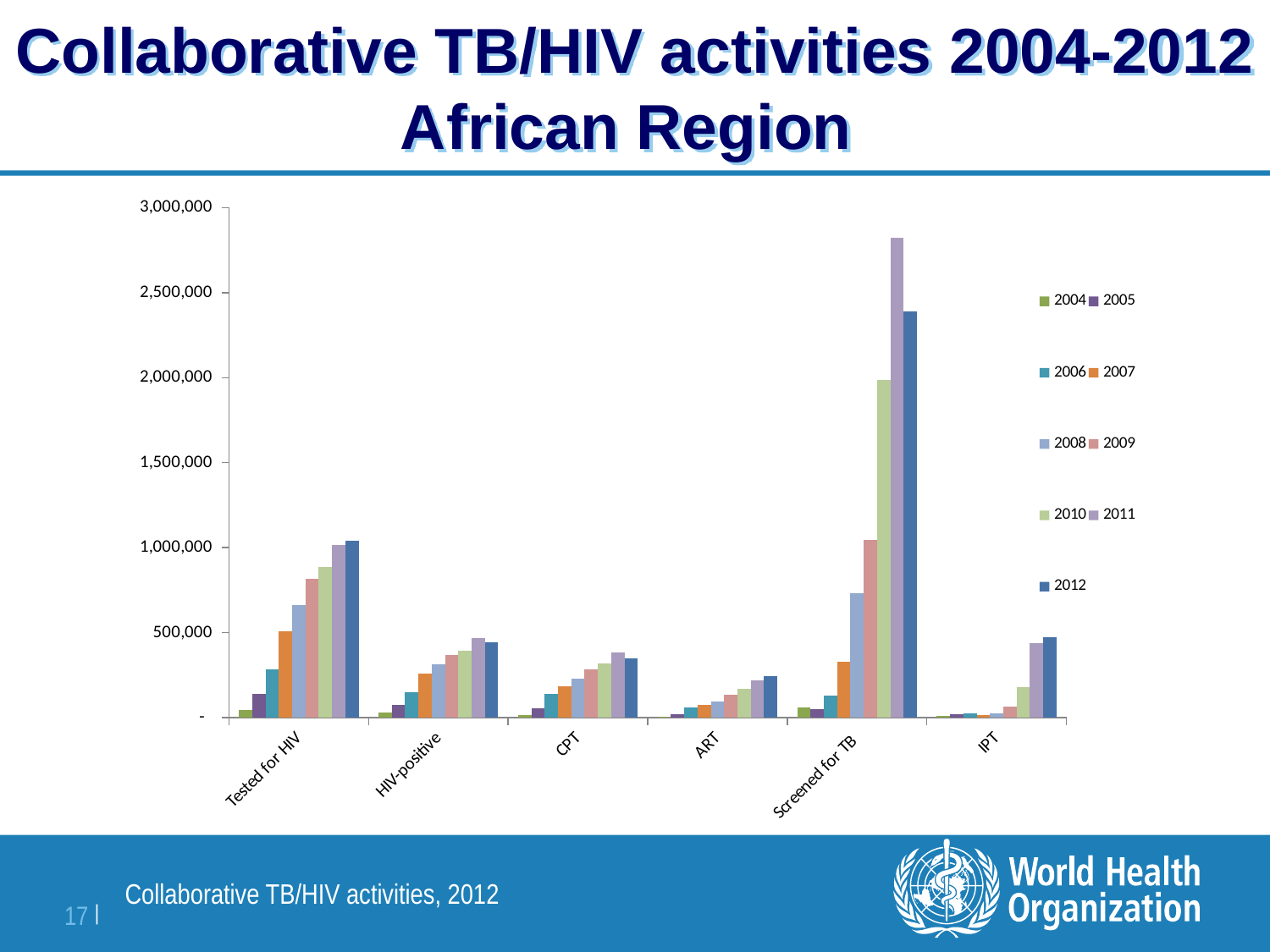
What kind of chart is shown on the slide? bar chart Is the 2011 value for Screened for TB greater or less than 2,500,000? greater Which category has the tallest bar in the chart? Screened for TB Is the 2008 value for Tested for HIV greater or less than 500,000? greater Within the Screened for TB category, which year has the highest value? 2011 Is the 2012 value for Screened for TB greater or less than 2,500,000? less How many series (years) does the chart's legend list? 9 Do the values for Tested for HIV rise or fall from 2004 to 2012? rise Which is larger: the 2011 value for Screened for TB or the 2012 value for Tested for HIV? 2011 value for Screened for TB What is the first year listed in the chart's legend? 2004 How many categories are shown along the x axis of the chart? 6